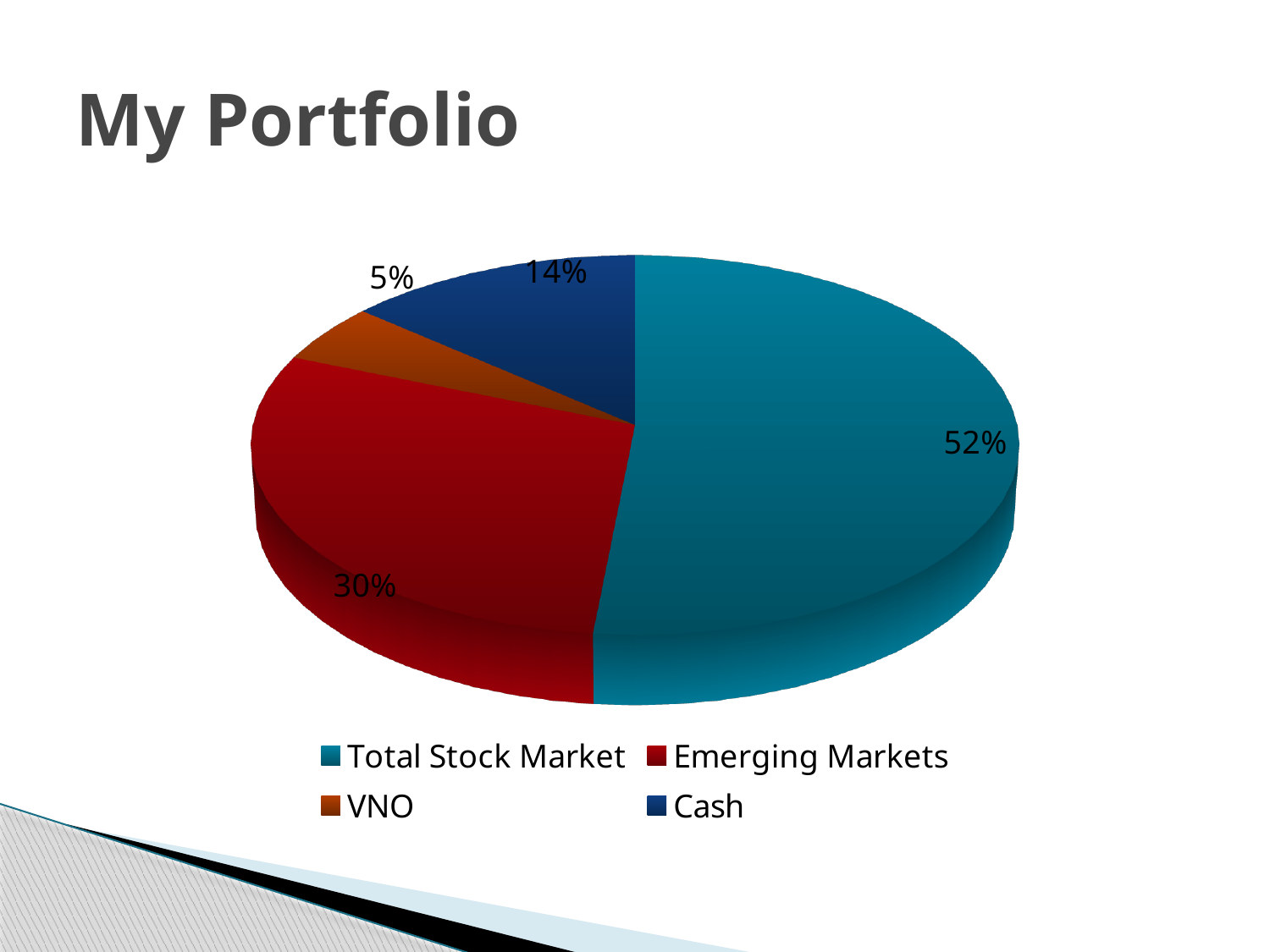
Which is larger, the Cash share or the VNO share? Cash What share of the portfolio is VNO? 5% What share of the portfolio is Total Stock Market? 52% What colour is the Emerging Markets slice? red What is the difference between the Total Stock Market share and the Emerging Markets share? 22% What is the title of the slide? My Portfolio Which category has the smallest slice of the pie? VNO What kind of chart is shown on the slide? pie chart What share of the portfolio is Emerging Markets? 30% How many categories does the pie chart have? 4 Which category has the largest slice of the pie? Total Stock Market